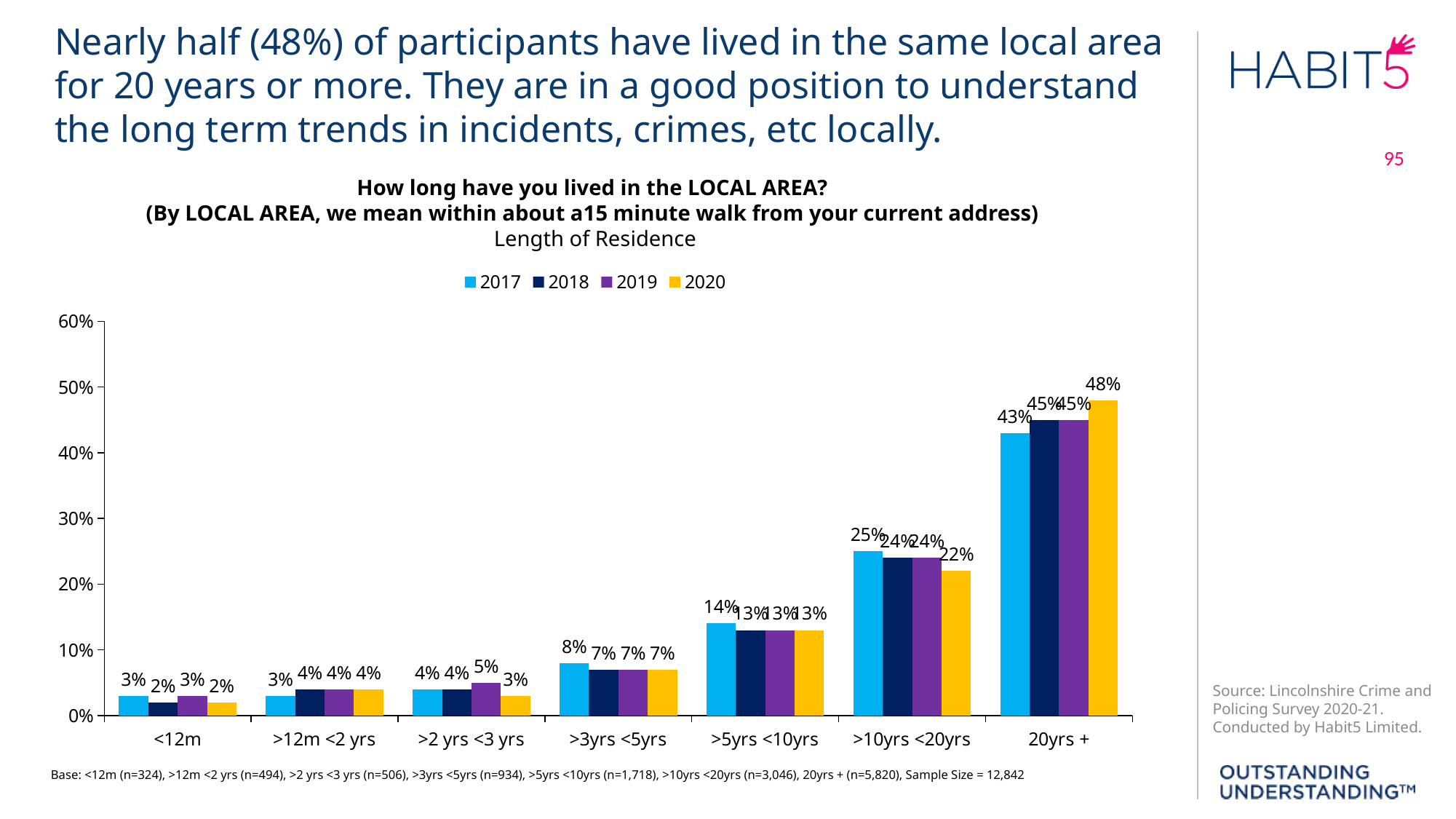
How many categories are shown on the x axis? 7 For the >10yrs <20yrs category, which is larger: the 2017 value or the 2020 value? 2017 What is the 2019 value for the >2 yrs <3 yrs category? 5% What kind of chart is shown on the slide? bar chart How many series does the legend list? 4 What is the 2020 value for the 20yrs + category? 48% What is the 2017 value for the >10yrs <20yrs category? 25% What is the difference between the 2020 and 2017 values for the 20yrs + category? 5% Is the 2020 value for the >10yrs <20yrs category greater or less than 30%? less What is the 2018 value for the <12m category? 2% Which category has the highest value for 2020? 20yrs +